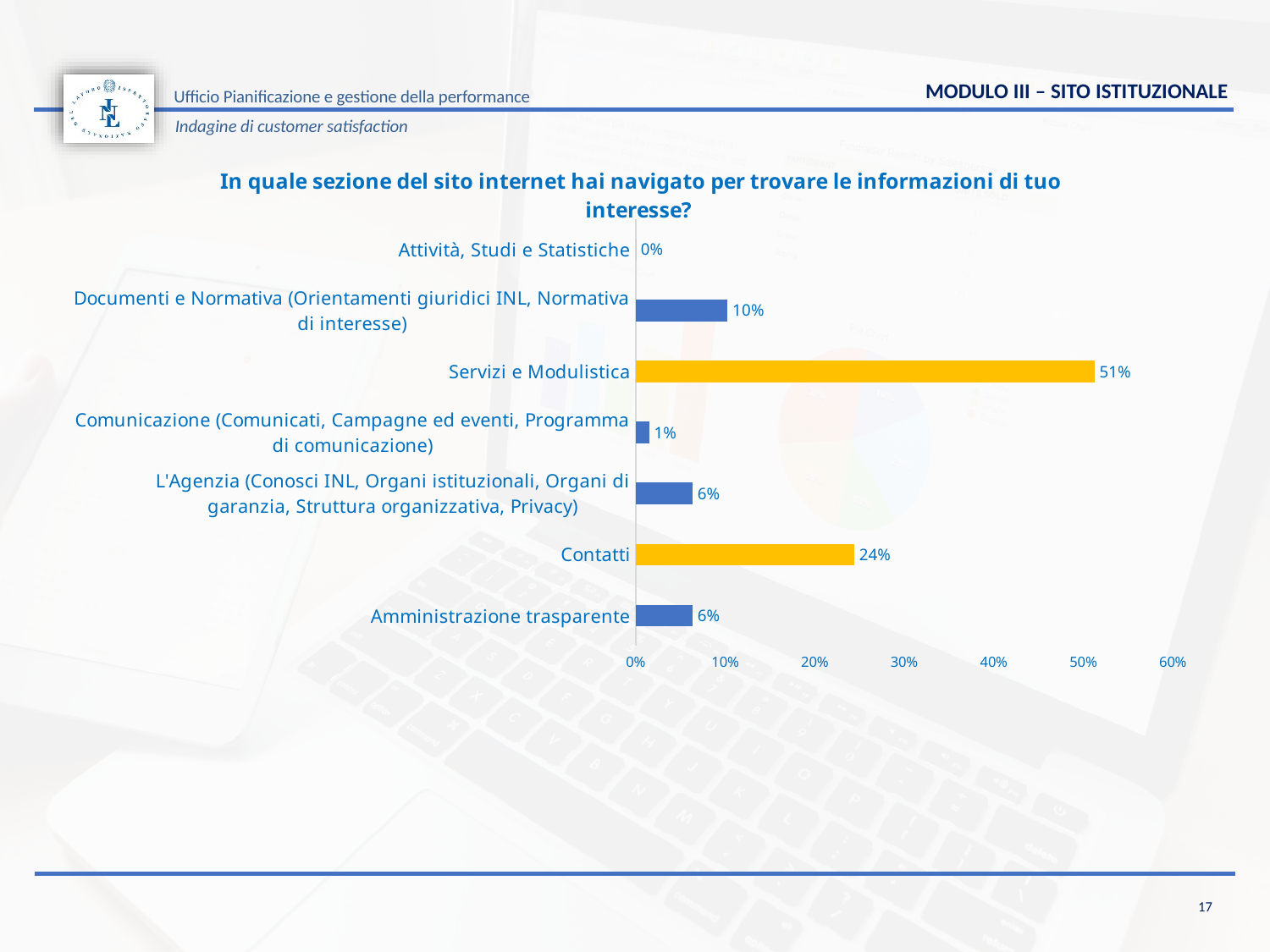
What is the title of the chart? In quale sezione del sito internet hai navigato per trovare le informazioni di tuo interesse? Which category has the highest value? Servizi e Modulistica How many categories are shown in the chart? 7 Which category has the lowest value? Attività, Studi e Statistiche What is the value for Contatti? 24% What is the difference between the values for Servizi e Modulistica and Contatti? 27% Which is larger, the value for Documenti e Normativa or the value for Contatti? Contatti What is the value for Servizi e Modulistica? 51% What is the value for Attività, Studi e Statistiche? 0% What is the value for Amministrazione trasparente? 6% Is the value for Servizi e Modulistica greater or less than 40%? greater What kind of chart is shown on the slide? bar chart